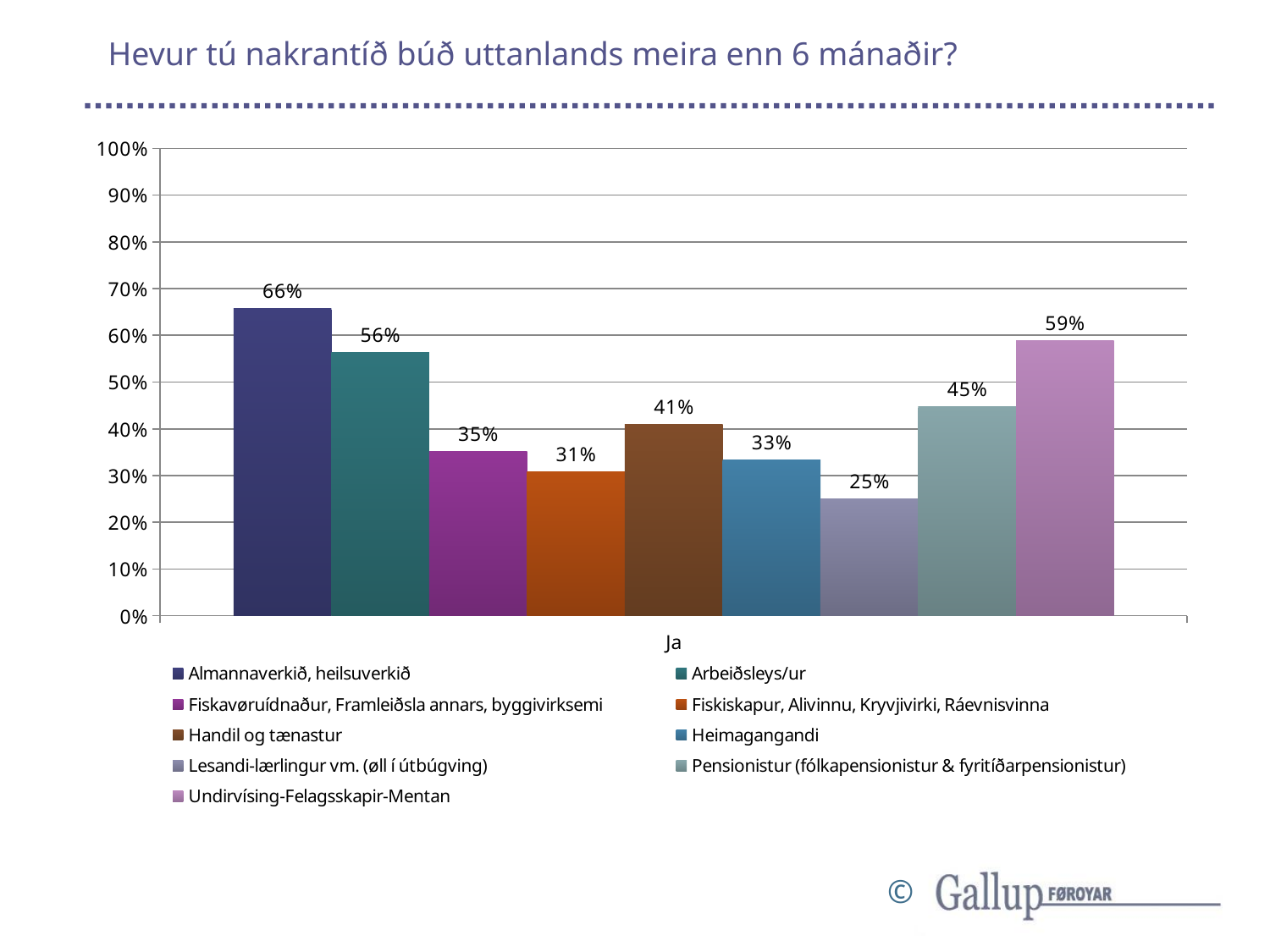
What is the value for Lesandi-lærlingur vm. (øll í útbúgving)? 25% Which series has the lowest value? Lesandi-lærlingur vm. (øll í útbúgving) What is the value for Almannaverkið, heilsuverkið? 66% What is the value for Pensionistur (fólkapensionistur & fyritíðarpensionistur)? 45% What is the value for Handil og tænastur? 41% How many series does the legend list? 9 What is the difference between the values for Arbeiðsleys/ur and Heimagangandi? 23% Is the value for Fiskiskapur, Alivinnu, Kryvjivirki, Ráevnisvinna greater or less than 40%? less What kind of chart is shown on the slide? bar chart What is the title of the slide? Hevur tú nakrantíð búð uttanlands meira enn 6 mánaðir? Which series has the highest value? Almannaverkið, heilsuverkið Which is larger, the value for Undirvísing-Felagsskapir-Mentan or the value for Arbeiðsleys/ur? Undirvísing-Felagsskapir-Mentan